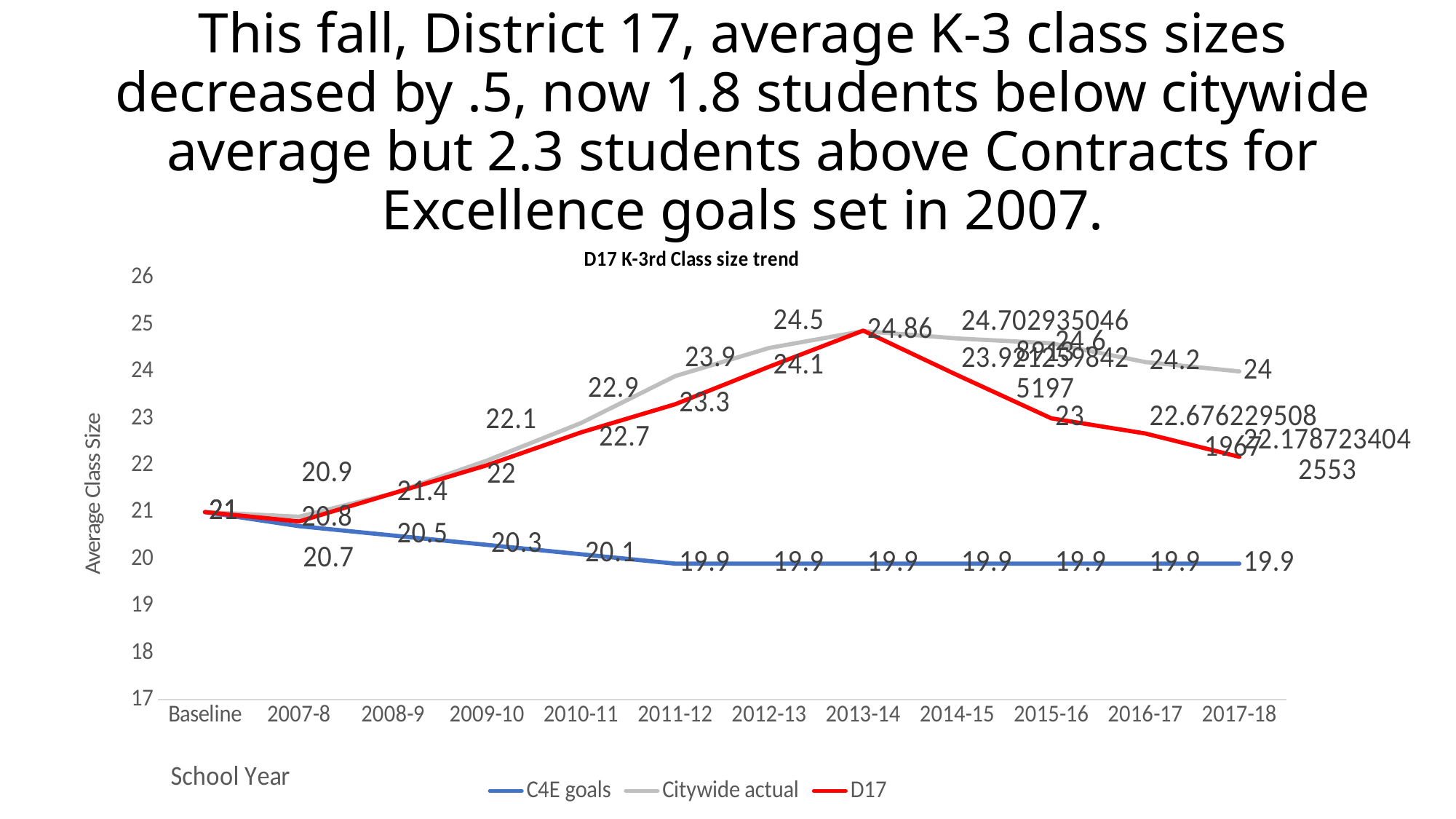
What is the D17 value for 2015-16? 23 What is the C4E goals value for 2017-18? 19.9 What is the Citywide actual value for 2012-13? 24.5 What kind of chart is shown on the slide? line chart In 2016-17, which is larger: Citywide actual or D17? Citywide actual How many school-year categories are shown on the x axis? 12 How many series does the legend list? 3 What is the Citywide actual value for 2009-10? 22.1 Do the C4E goals values rise or fall from Baseline to 2011-12? fall What is the difference between the Citywide actual and D17 values in 2011-12? 0.6 What is the D17 value for 2010-11? 22.7 In which school year does the D17 series reach its highest value? 2013-14